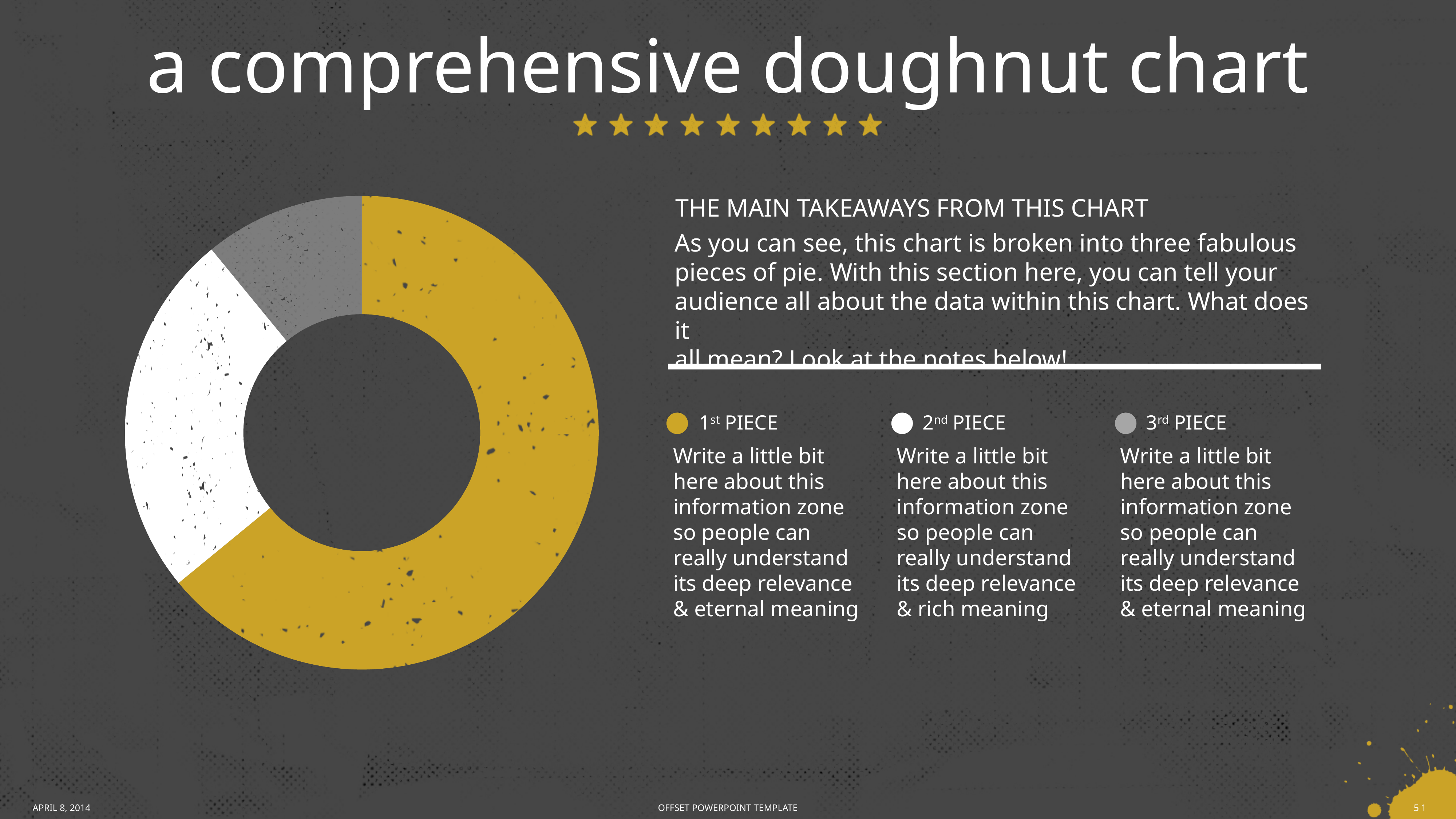
Which is larger in the doughnut chart, the 2nd PIECE or the 3rd PIECE? 2nd PIECE Which piece of the doughnut chart is the smallest? 3rd PIECE Which piece of the doughnut chart is the largest? 1st PIECE Which is smaller in the doughnut chart, the 1st PIECE or the 3rd PIECE? 3rd PIECE Which is larger in the doughnut chart, the 1st PIECE or the 2nd PIECE? 1st PIECE What kind of chart is shown on the slide? doughnut chart What colour represents the 1st PIECE in the doughnut chart? yellow What colour represents the 3rd PIECE in the doughnut chart? grey How many pieces is the doughnut chart divided into? 3